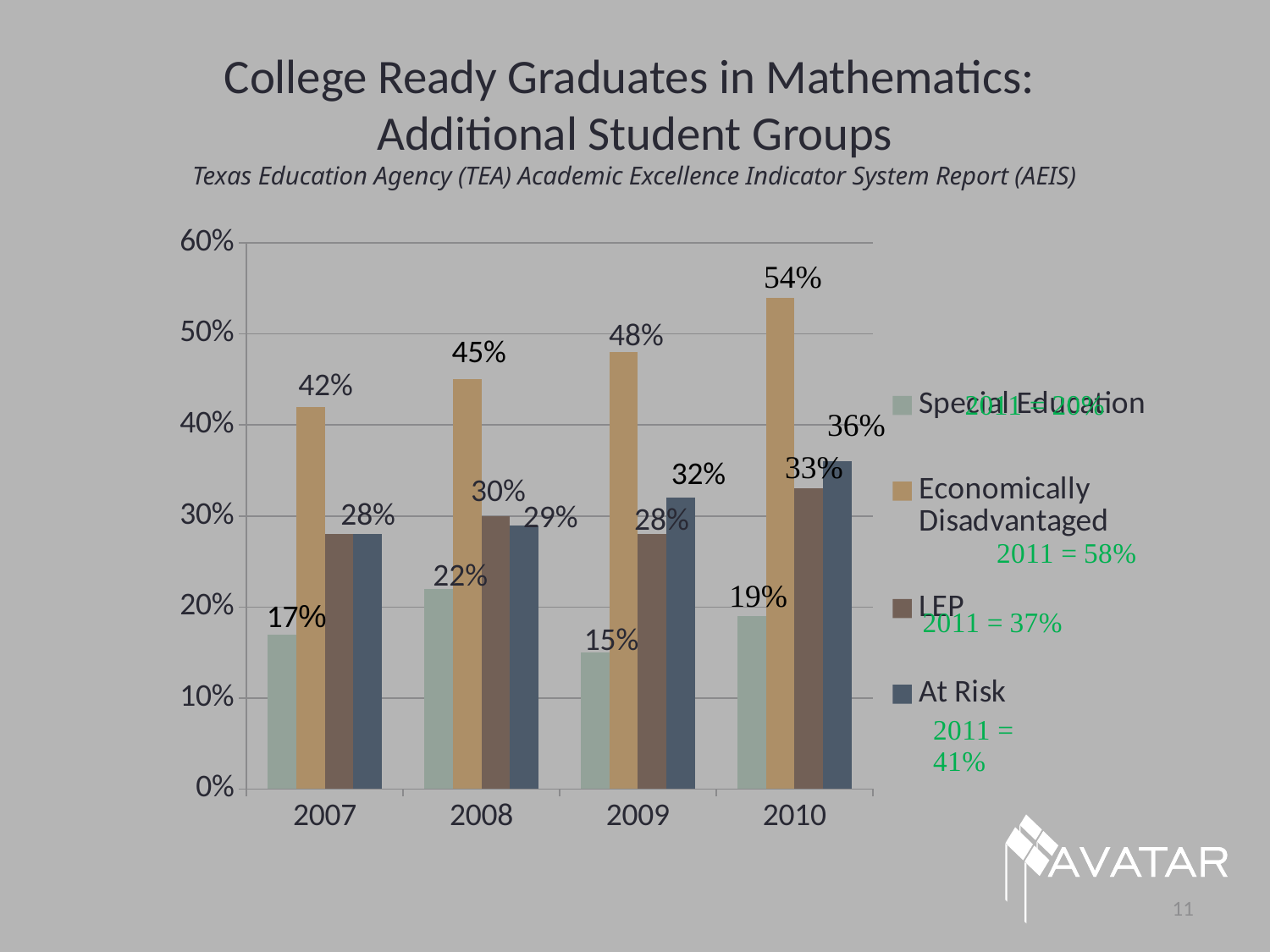
How many years are shown on the x axis? 4 In which year is the Special Education value lowest? 2009 What kind of chart is shown on the slide? bar chart What is the value for Special Education in 2009? 15% In which year is the Economically Disadvantaged value highest? 2010 What is the value for Economically Disadvantaged in 2010? 54% What is the difference between the Economically Disadvantaged values in 2010 and 2007? 12 percentage points Is the value for At Risk in 2007 greater or less than 30%? less What is the value for At Risk in 2009? 32% Do the Economically Disadvantaged values rise or fall from 2007 to 2010? rise How many series does the legend list? 4 In 2010, which is larger: the At Risk value or the LEP value? At Risk